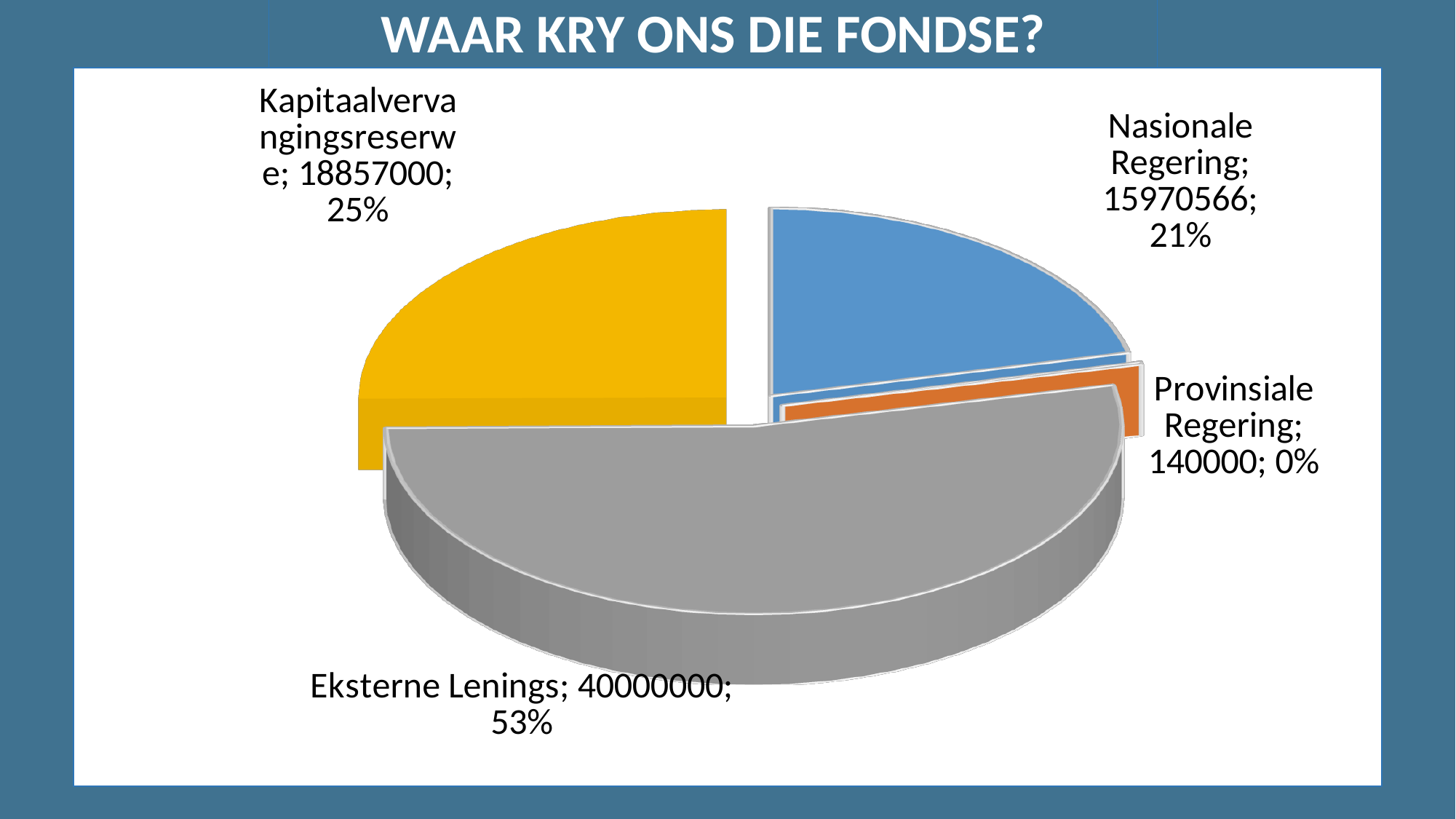
How many categories are shown in the pie chart? 4 What is the value for Eksterne Lenings? 40000000 What is the title of the slide? WAAR KRY ONS DIE FONDSE? Which category has the smallest slice? Provinsiale Regering What share of the pie does Nasionale Regering represent? 21% What kind of chart is shown on the slide? pie chart What is the value for Provinsiale Regering? 140000 What is the value for Kapitaalvervangingsreserwe? 18857000 What share of the pie does Eksterne Lenings represent? 53% What is the value for Nasionale Regering? 15970566 Which category has the largest slice? Eksterne Lenings Which is larger, Kapitaalvervangingsreserwe or Nasionale Regering? Kapitaalvervangingsreserwe